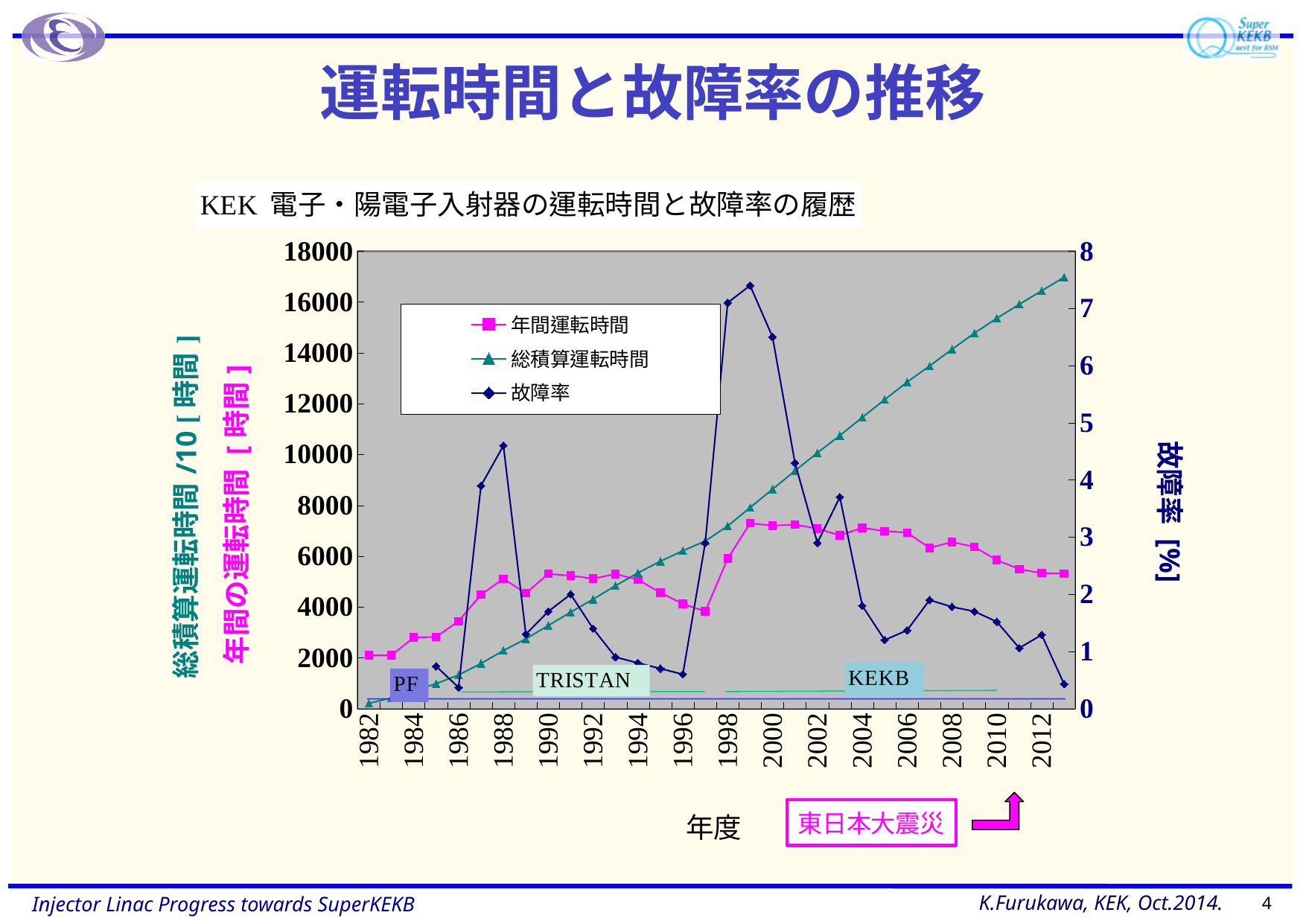
How many series does the chart legend list? 3 What are the three series named in the chart legend? 年間運転時間, 総積算運転時間, 故障率 Is the 年間運転時間 value for 2013 greater or less than 6000? less What kind of chart is shown on the slide? line chart Is the 故障率 value for 1999 greater or less than 6 on the right axis? greater In which year does the 故障率 series reach its highest value? 1999 What is the title printed above the chart? KEK 電子・陽電子入射器の運転時間と故障率の履歴 Is the 総積算運転時間 value for 2013 greater or less than 16000? greater Which is larger, the 年間運転時間 value for 1999 or for 1982? 1999 Does the 総積算運転時間 series rise or fall from 1982 to 2013? rise